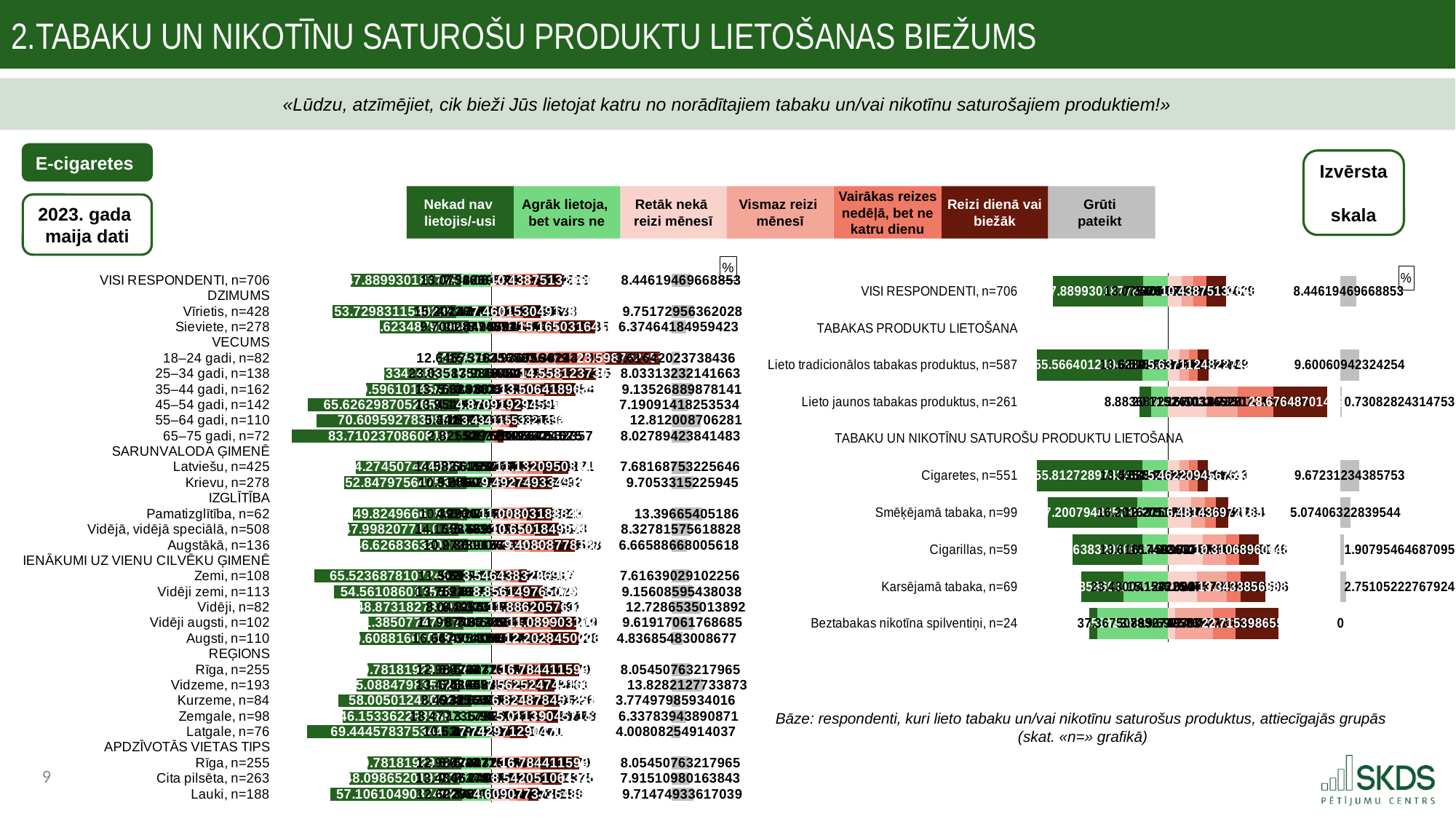
On the left chart, which group has the lowest 'Grūti pateikt' value? Kurzeme, n=84 On the left chart, what is the difference between the 'Grūti pateikt' values for Vīrietis, n=428 and Sieviete, n=278? 3.37708771402605 On the right chart, what is the 'Grūti pateikt' value for Smēķējamā tabaka, n=99? 5.07406322839544 How many groups (bars) are plotted on the right chart? 8 What kind of chart is used on the slide? Stacked bar chart How many series does the legend list? 7 On the left chart, which has the larger 'Grūti pateikt' value: Vīrietis, n=428 or Sieviete, n=278? Vīrietis, n=428 On the right chart, which group has the lowest 'Grūti pateikt' value? Beztabakas nikotīna spilventiņi, n=24 On the left chart, what is the 'Grūti pateikt' value for Vīrietis, n=428? 9.75172956362028 On the left chart, what is the 'Grūti pateikt' value for VISI RESPONDENTI, n=706? 8.44619469668853 On the right chart, what is the 'Grūti pateikt' value for Lieto jaunos tabakas produktus, n=261? 0.73082824314753 On the left chart, which group has the highest 'Grūti pateikt' value? Vidzeme, n=193